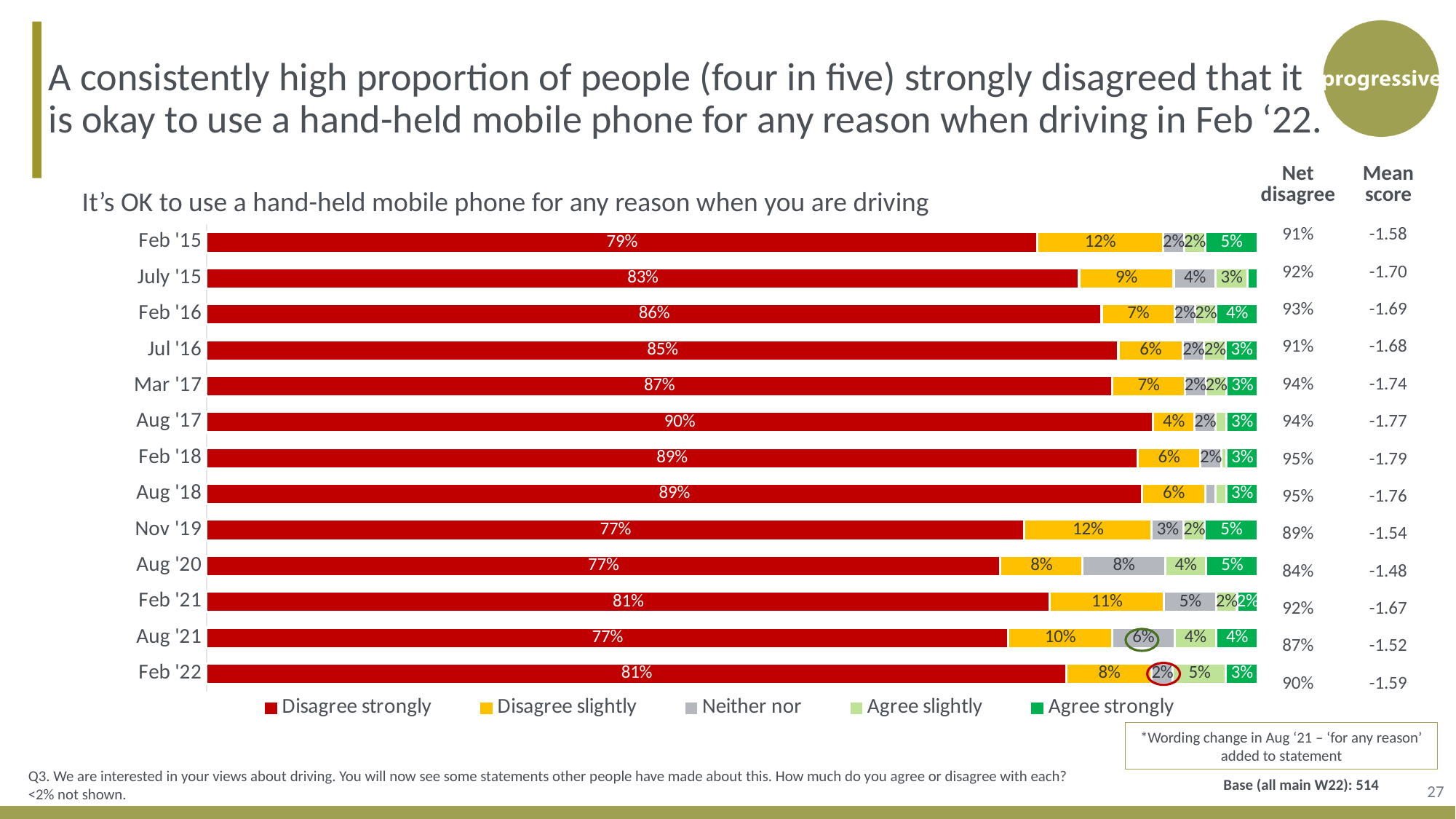
What percentage of people disagreed strongly in Feb '22? 81% What is the 'Agree slightly' value for Feb '22? 5% What is the 'Disagree slightly' value for Nov '19? 12% Which legend entry is shown in red? Disagree strongly Which wave has the highest 'Neither nor' value? Aug '20 What kind of chart is shown on the slide? Stacked bar chart Which is larger: the 'Agree strongly' value for Aug '20 or for Feb '22? Aug '20 What is the difference in the 'Disagree strongly' share between Feb '22 and Feb '15? 2 percentage points How many series does the legend list? 5 How many survey waves (categories) are plotted on the chart? 13 What is the 'Neither nor' value for Aug '20? 8% In which wave was the 'Disagree strongly' share highest? Aug '17